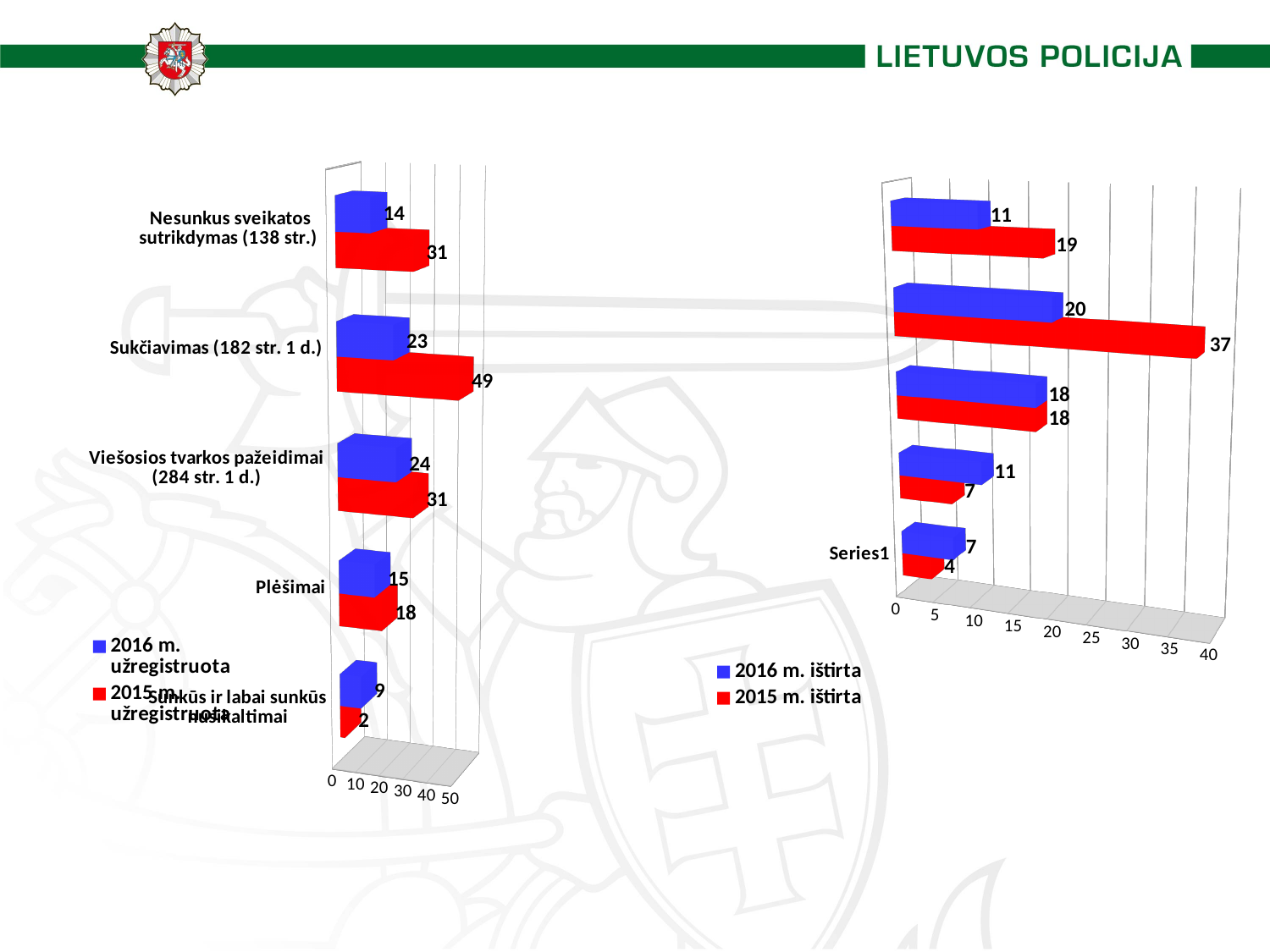
On the left chart, which category has the highest 2015 m. užregistruota value? Sukčiavimas (182 str. 1 d.) On the left chart, what is the difference between the 2015 m. užregistruota and 2016 m. užregistruota values for Sukčiavimas (182 str. 1 d.)? 26 On the right chart, what is the 2016 m. ištirta value for the category labelled Series1? 7 What kind of chart is the right chart? Bar chart On the left chart, what is the 2015 m. užregistruota value for Nesunkus sveikatos sutrikdymas (138 str.)? 31 How many categories does the left chart show? 5 On the left chart, for Plėšimai, which is larger: the 2016 m. užregistruota value or the 2015 m. užregistruota value? 2015 m. užregistruota How many series does the legend of the left chart list? 2 On the right chart, what is the highest 2015 m. ištirta value shown? 37 On the right chart, what is the difference between the 2015 m. ištirta and 2016 m. ištirta values for the category labelled Series1? 3 On the left chart, which category has the lowest 2016 m. užregistruota value? Sunkūs ir labai sunkūs nusikaltimai On the left chart, what is the 2016 m. užregistruota value for Sukčiavimas (182 str. 1 d.)? 23